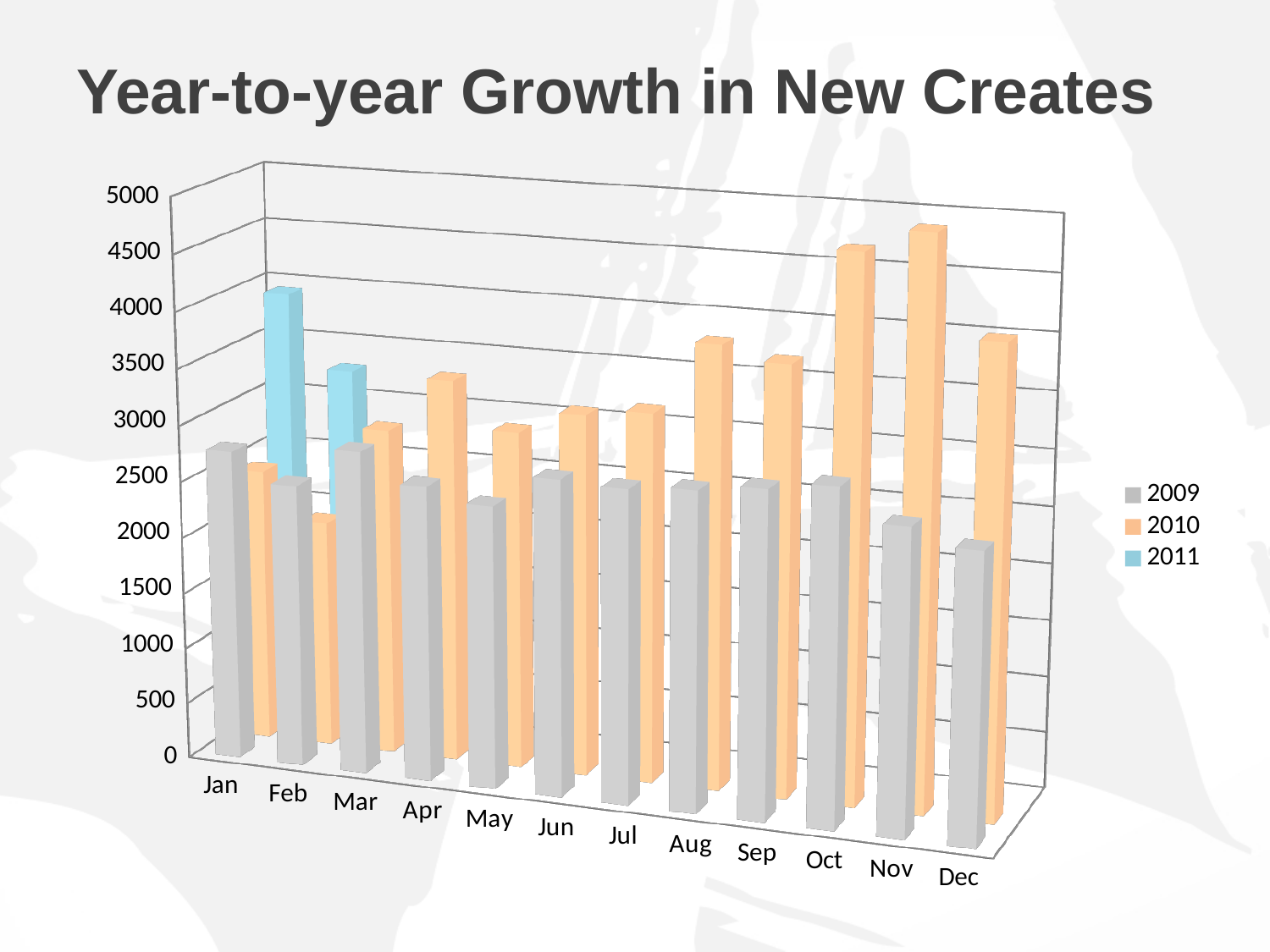
For Feb, which series has the larger value, 2009 or 2010? 2009 Is the 2010 value for Nov greater or less than 4000? greater In which month is the 2010 value highest? Nov For Jan, which series has the larger value, 2010 or 2011? 2011 What colour represents the 2011 series? blue How many months are shown on the x axis? 12 What kind of chart is shown on the slide? bar chart For how many months is a 2011 value plotted? 2 In which month is the 2010 value lowest? Feb How many series does the legend list? 3